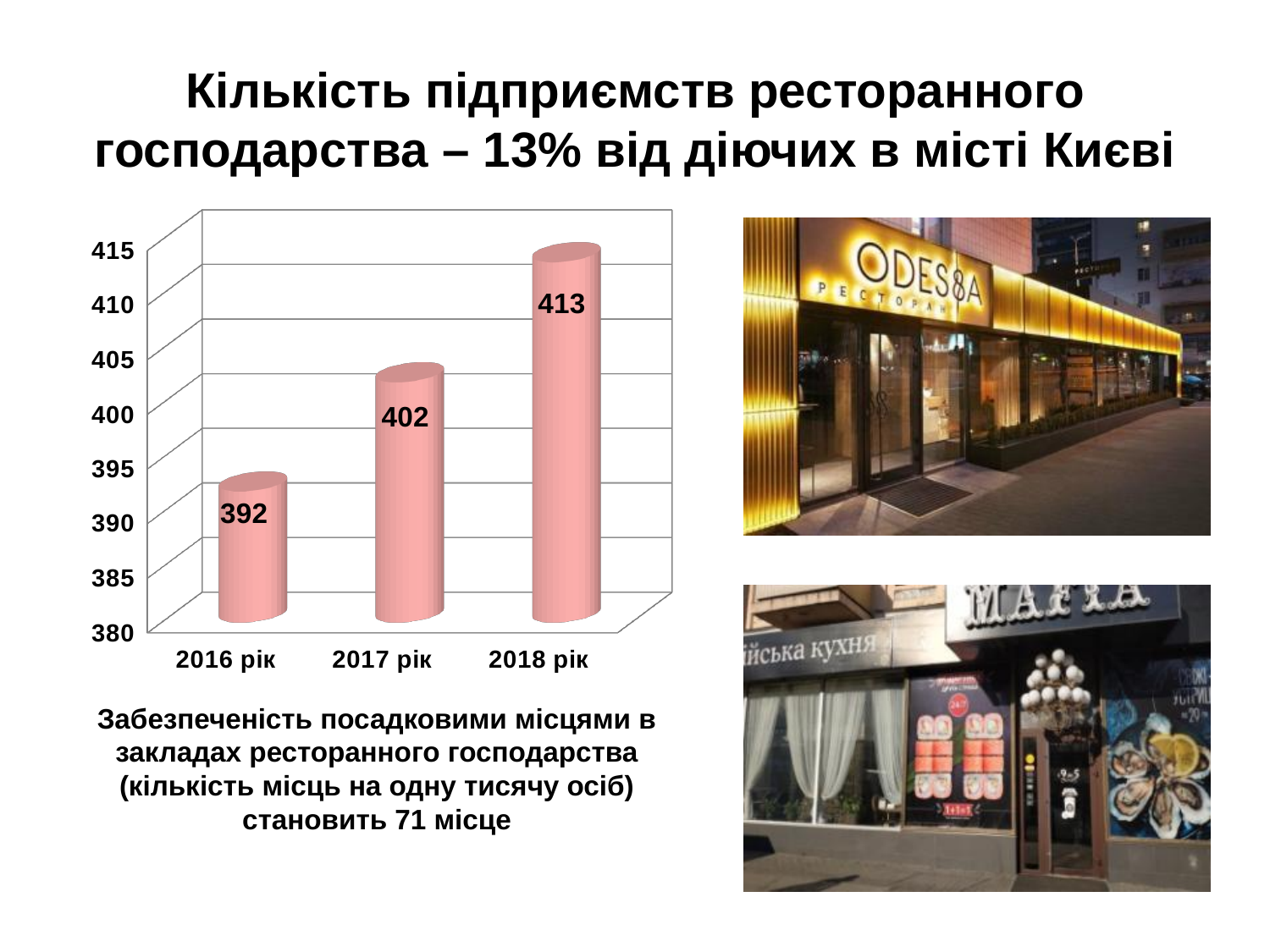
Which is larger, the value for 2017 рік or the value for 2018 рік? 2018 рік What is the difference between the values for 2018 рік and 2016 рік? 21 Is the value for 2017 рік greater or less than 400? greater What kind of chart is shown on the slide? bar chart Which year has the lowest value? 2016 рік Do the values rise or fall from 2016 рік to 2018 рік? rise Which year has the highest value? 2018 рік What is the value for 2016 рік? 392 What is the value for 2018 рік? 413 What is the difference between the values for 2017 рік and 2016 рік? 10 What is the value for 2017 рік? 402 How many categories are shown on the x axis? 3